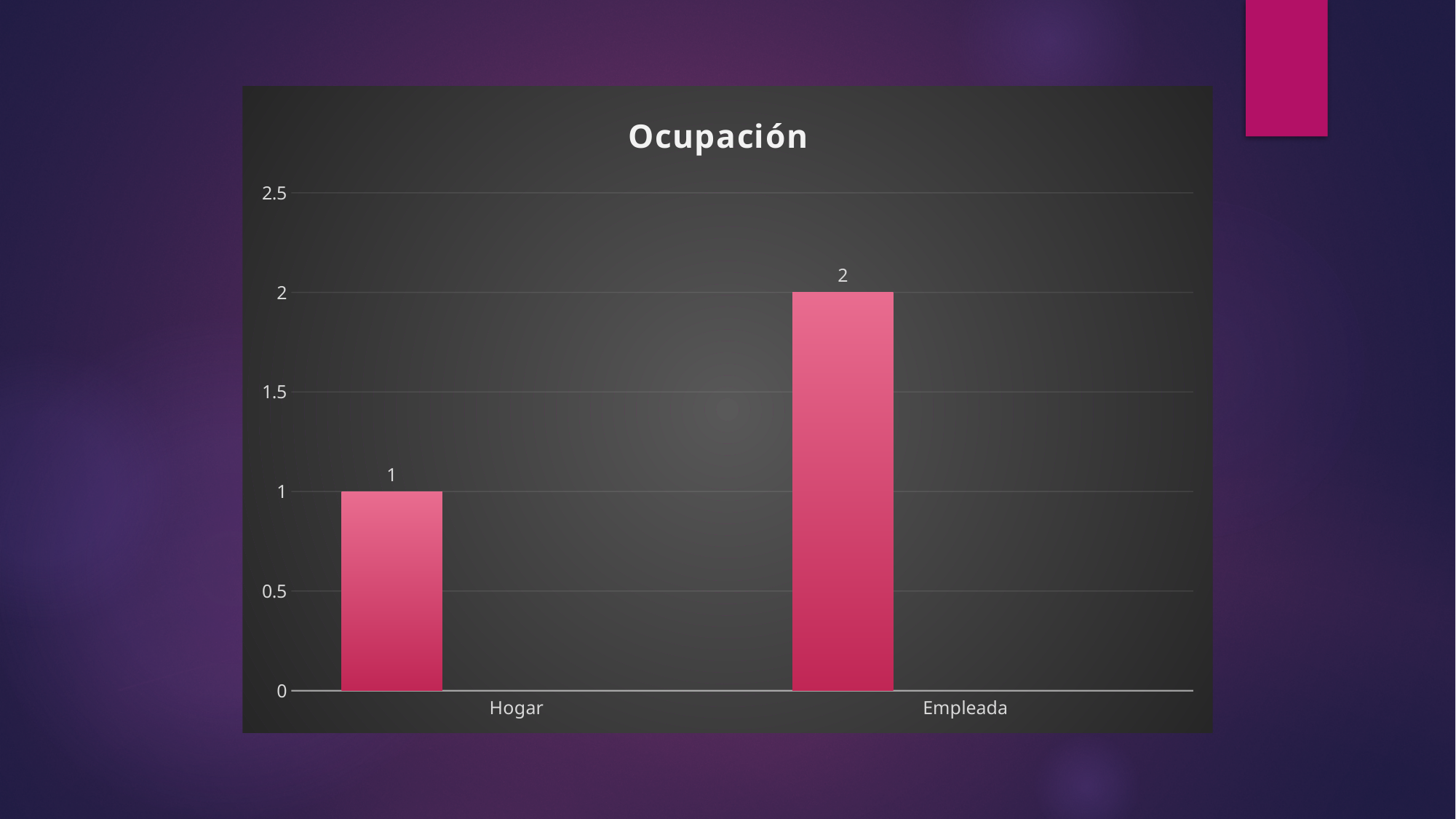
Do the values rise or fall from Hogar to Empleada? rise What is the value for Empleada? 2 How many categories are shown on the x axis? 2 What is the difference between the values for Empleada and Hogar? 1 Is the value for Hogar greater or less than 1.5? less Which category has the lowest value? Hogar What is the value for Hogar? 1 Is the value for Empleada greater or less than 1.5? greater What is the title of the chart? Ocupación What kind of chart is shown on the slide? bar chart Which category has the highest value? Empleada Which is larger, the value for Hogar or the value for Empleada? Empleada